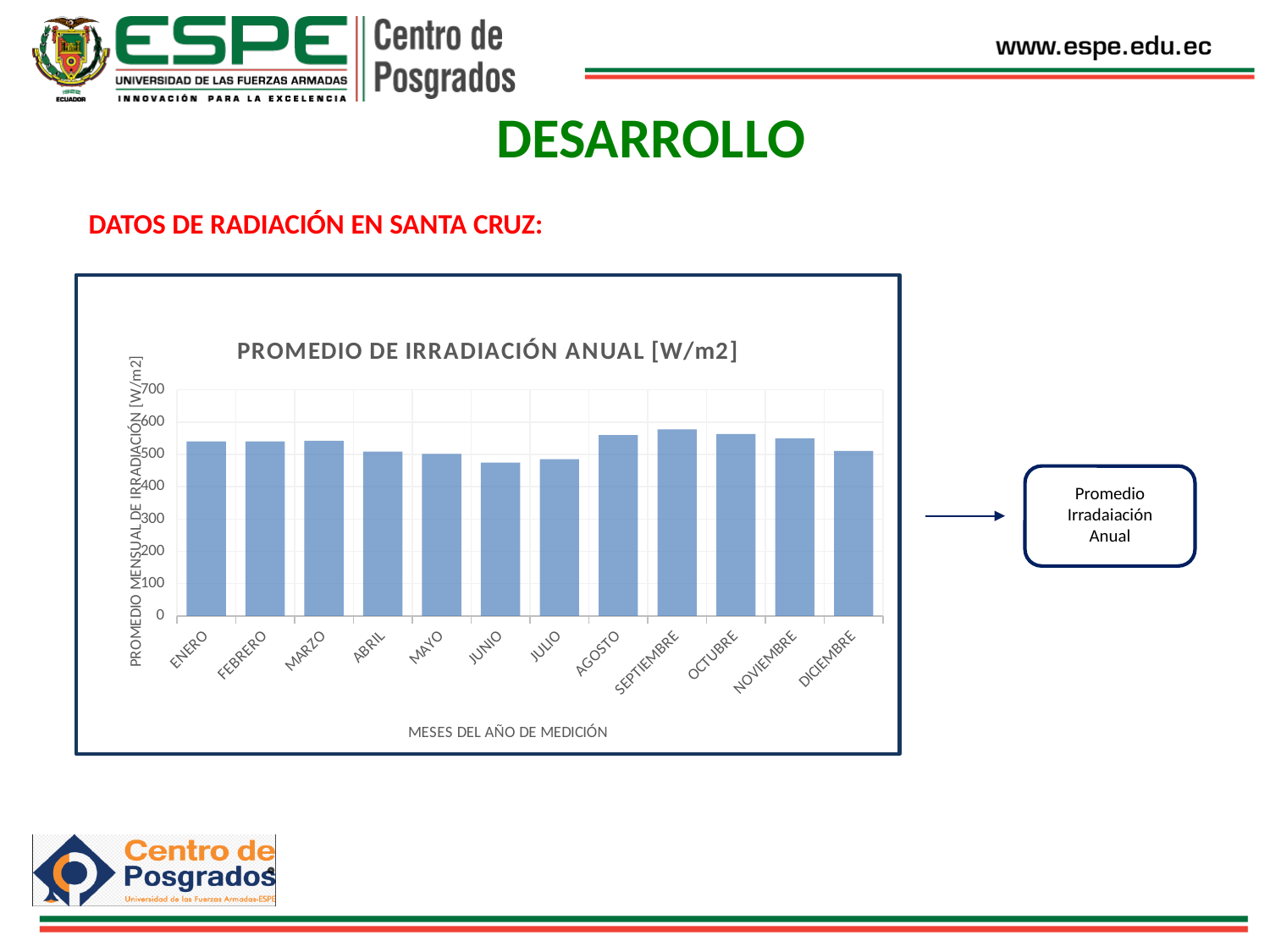
What is the label of the horizontal axis of the chart? MESES DEL AÑO DE MEDICIÓN Do the values rise or fall from MARZO to JUNIO? fall Is the value for ENERO greater or less than 600? less What is the title of the chart? PROMEDIO DE IRRADIACIÓN ANUAL [W/m2] How many months (categories) are plotted in the chart? 12 Which is larger, the value for JULIO or the value for OCTUBRE? OCTUBRE Which month has the highest average irradiation in the chart? SEPTIEMBRE Is the value for JUNIO greater or less than 500? less What kind of chart is shown on the slide? Bar chart Which month has the lowest average irradiation in the chart? JUNIO Which is larger, the value for AGOSTO or the value for ABRIL? AGOSTO Is the value for SEPTIEMBRE greater or less than 500? greater